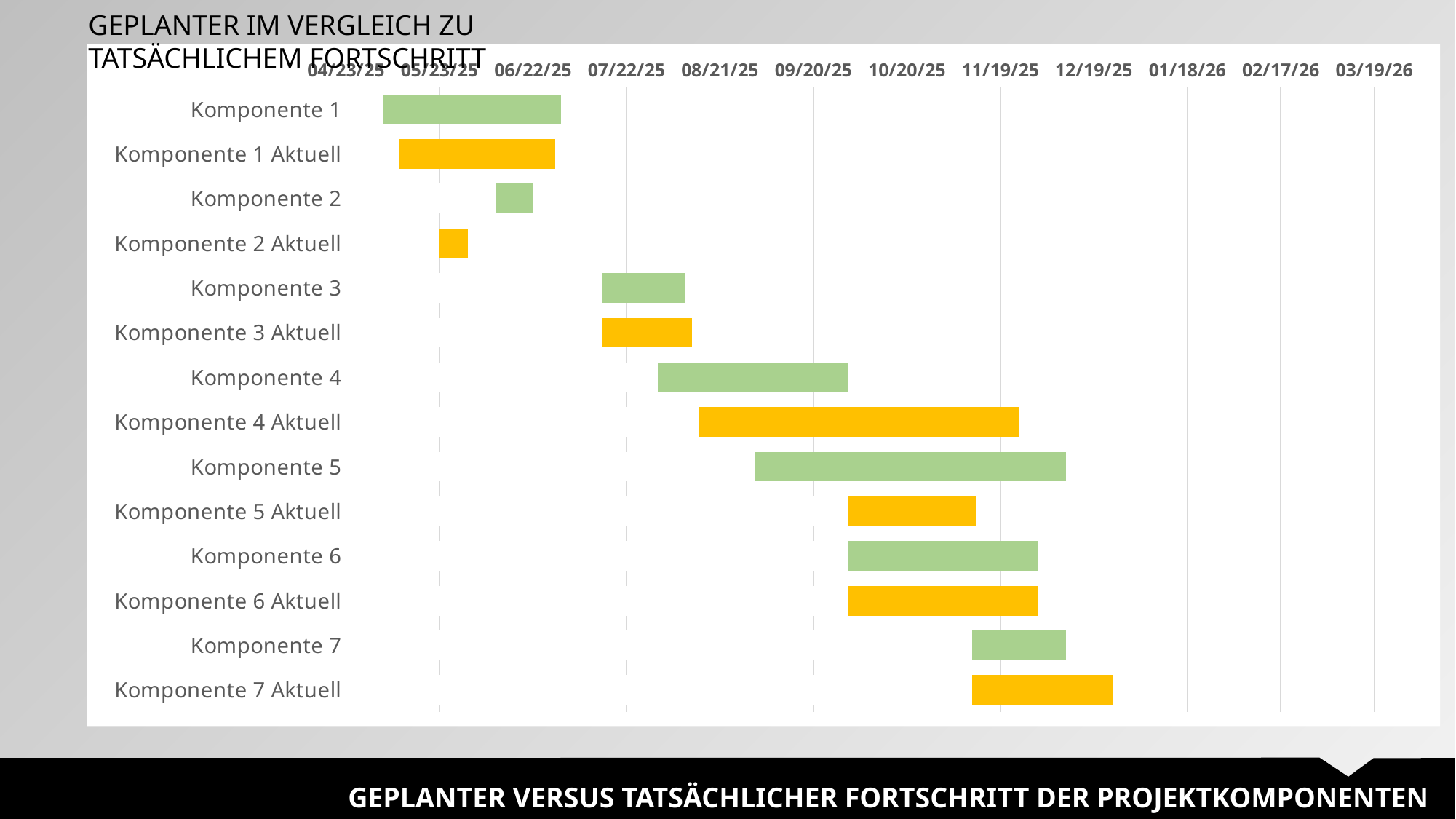
Which bar is longer, Komponente 1 or Komponente 2? Komponente 1 What is the first date label shown on the horizontal axis? 04/23/25 Does the bar for Komponente 4 start before or after 07/22/25? after Does the bar for Komponente 7 Aktuell end before or after 12/19/25? after Which bar is longer, Komponente 7 or Komponente 7 Aktuell? Komponente 7 Aktuell What kind of chart is shown on the slide? Bar chart (Gantt chart) How many category rows are listed on the vertical axis of the chart? 14 What colour are the bars for the 'Aktuell' rows? Yellow/orange Does the bar for Komponente 1 start before or after 05/23/25? before Which bar is longer, Komponente 4 or Komponente 4 Aktuell? Komponente 4 Aktuell Which row has the shortest bar in the chart? Komponente 2 Aktuell